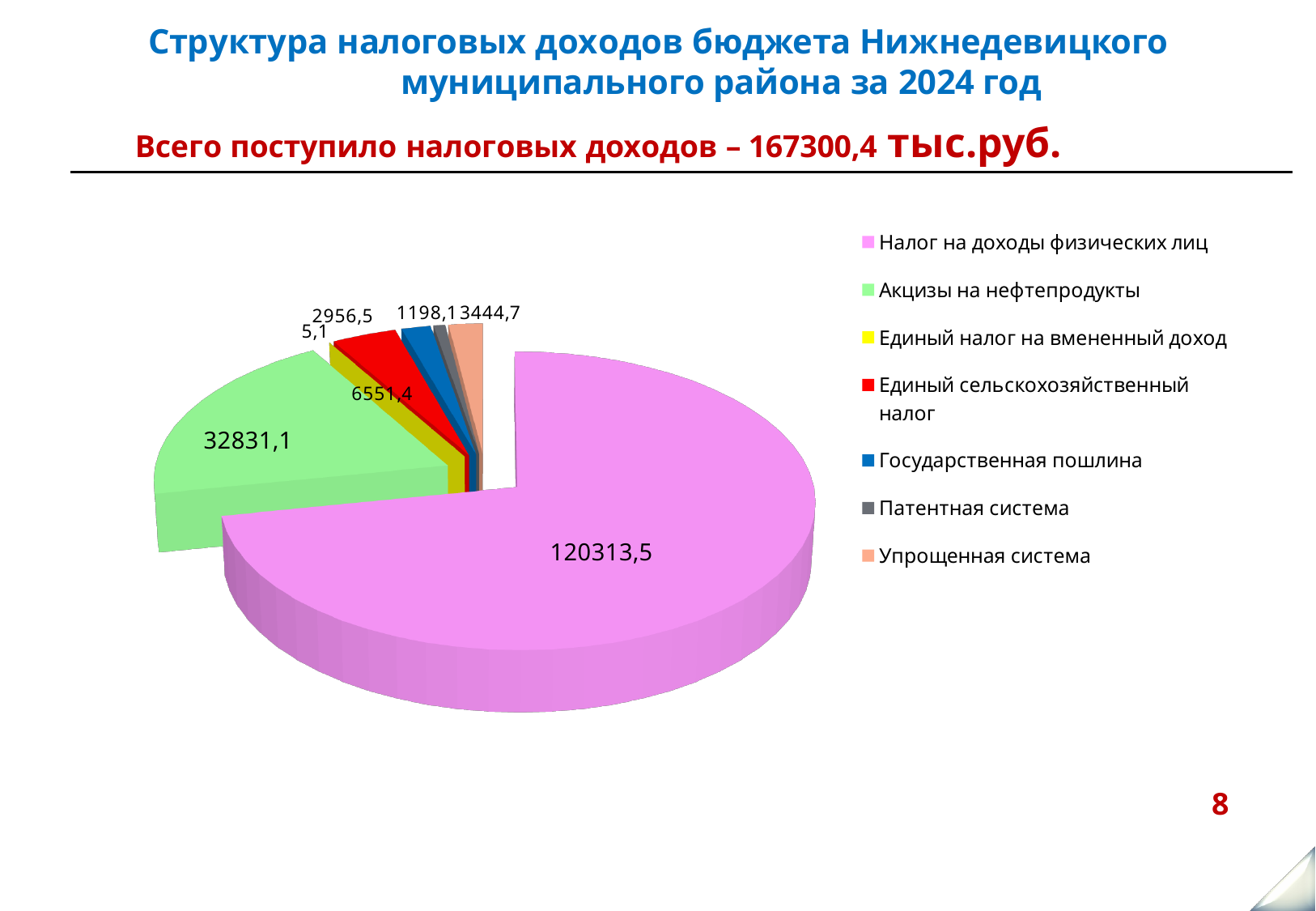
What is the difference between the values for Налог на доходы физических лиц and Акцизы на нефтепродукты? 87482,4 Which category has the smallest slice of the pie? Единый налог на вмененный доход Which category has the largest slice of the pie? Налог на доходы физических лиц Which is larger: Акцизы на нефтепродукты or Единый сельскохозяйственный налог? Акцизы на нефтепродукты How many entries does the legend list? 7 What is the value shown for Акцизы на нефтепродукты? 32831,1 What is the value shown for Единый сельскохозяйственный налог? 6551,4 What is the value shown for Налог на доходы физических лиц? 120313,5 What kind of chart is shown on the slide? pie chart What colour is the slice for Государственная пошлина? blue How many slices does the pie chart have? 7 What total amount of tax revenue is stated on the slide? 167300,4 тыс.руб.